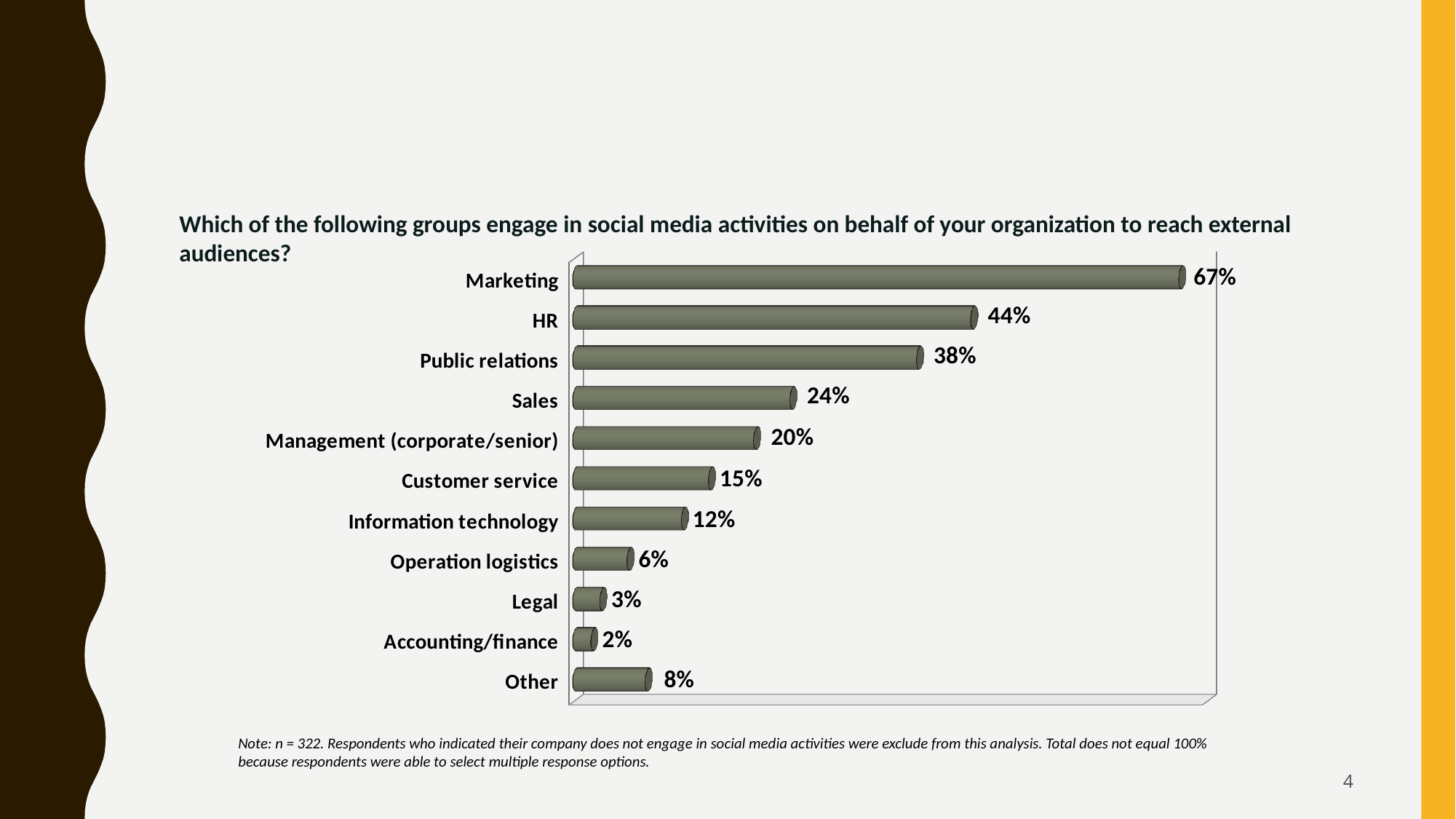
What sample size (n) is given in the note below the chart? 322 What percentage is shown for Information technology? 12% What kind of chart is shown on the slide? Bar chart Which is larger, the value for Management (corporate/senior) or the value for Customer service? Management (corporate/senior) What is the difference between the values for Customer service and Legal? 12% What is the difference between the values for HR and Sales? 20% How many groups are shown in the chart? 11 Which group has the lowest percentage? Accounting/finance What is the value for Other? 8% Which group has the highest percentage? Marketing What is the value for Public relations? 38% What percentage is shown for Marketing? 67%